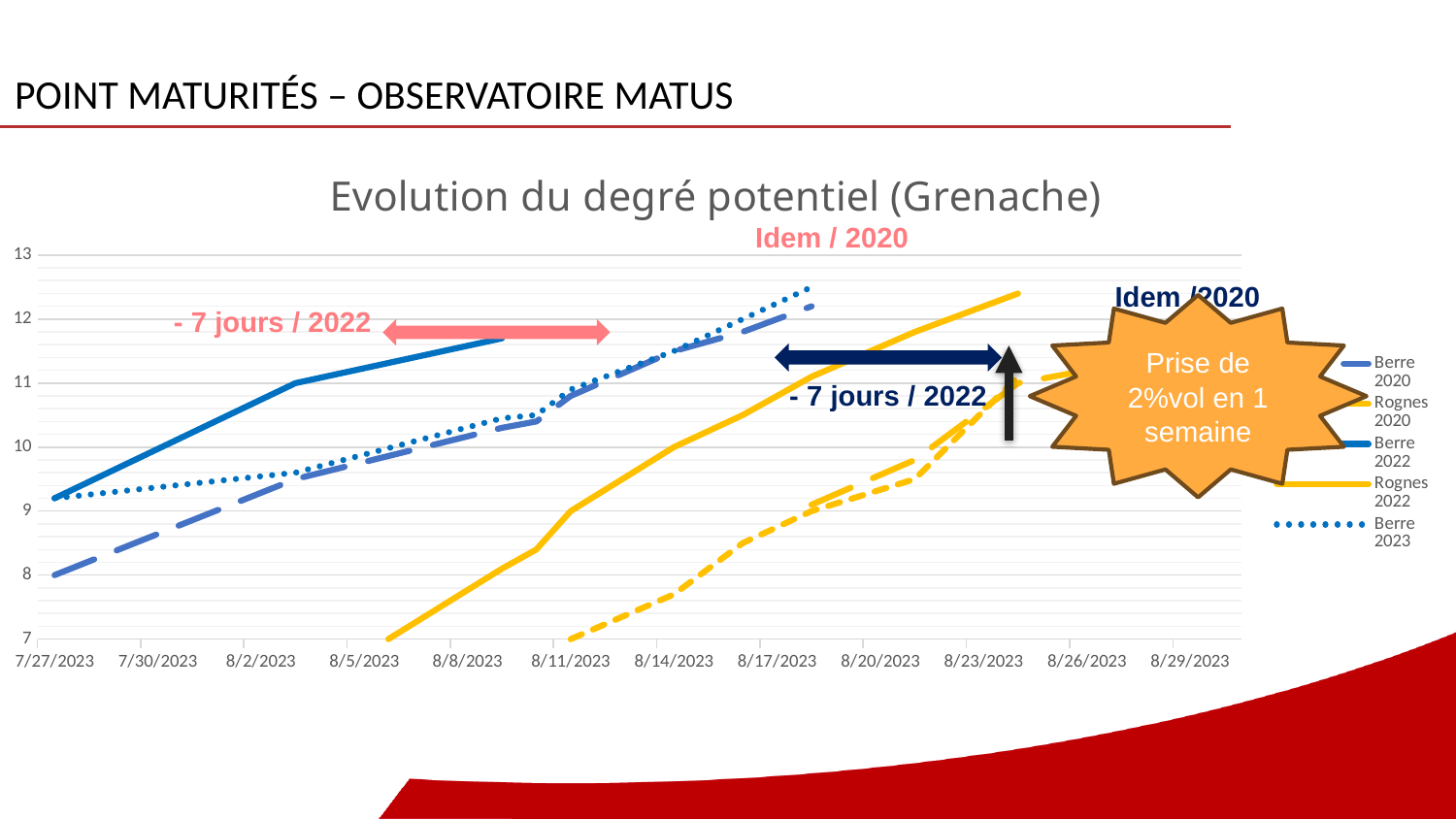
What is the title of the chart? Evolution du degré potentiel (Grenache) Is the value for Berre 2022 at 7/27/2023 greater or less than 9? greater Do the values of the Berre 2020 series rise or fall over time? rise Which series is drawn as a dotted line? Berre 2023 At 8/8/2023, which series has the larger value, Berre 2022 or Berre 2020? Berre 2022 How many series does the legend list? 5 Is the value for Berre 2022 at 8/8/2023 greater or less than 11? greater What kind of chart is shown on the slide? line chart Is the value for Rognes 2022 at 8/23/2023 greater or less than 12? greater Do the values of the Rognes 2022 series rise or fall along the x axis? rise